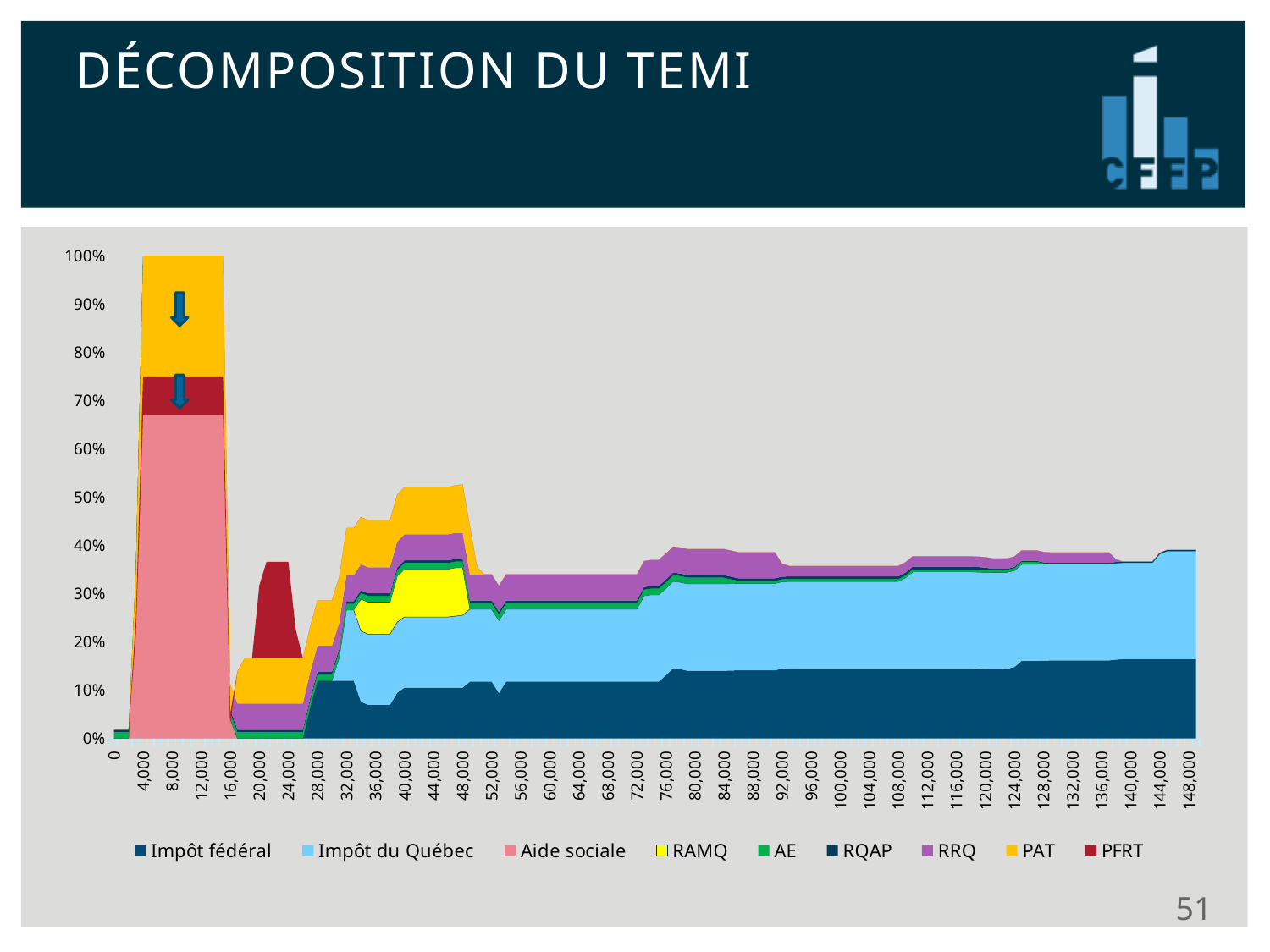
How many series does the legend list? 9 Is the total stacked value at 100,000 greater or less than 30%? greater What is the title of the slide containing the chart? DÉCOMPOSITION DU TEMI Which series accounts for the largest share of the stack at 8,000? Aide sociale What kind of chart is shown on the slide? Stacked area chart Is the total stacked value at 60,000 greater or less than 40%? less Which series is listed first in the legend? Impôt fédéral Is the total stacked value higher at 8,000 or at 40,000? 8,000 Is the total stacked value at 8,000 greater or less than 90%? greater Between 52,000 and 148,000, does the top of the stacked area generally rise or fall? rise